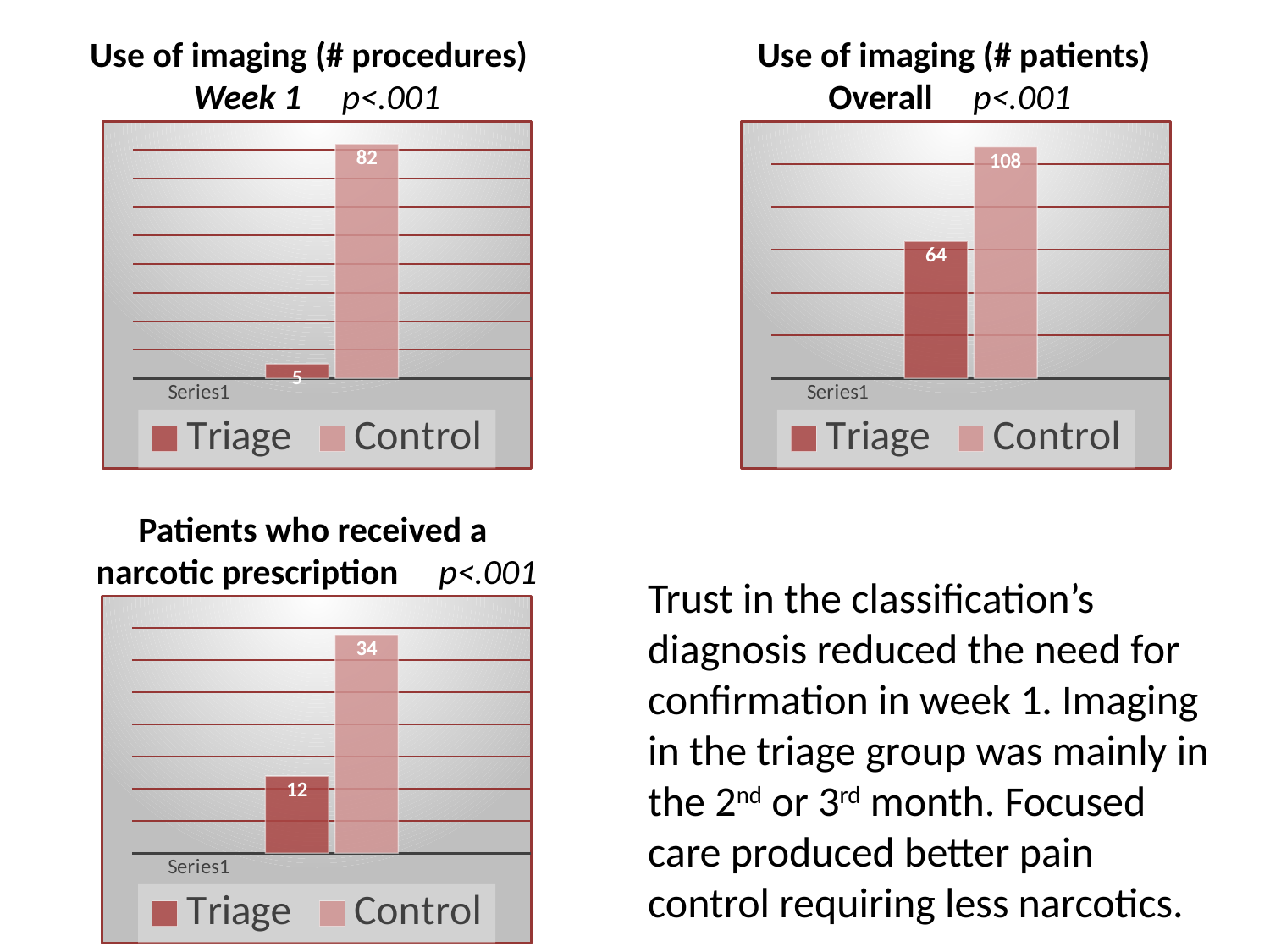
In the 'Use of imaging (# procedures) Week 1' chart, what is the value for Control? 82 In the 'Patients who received a narcotic prescription' chart, which series has the lower value? Triage In the 'Use of imaging (# procedures) Week 1' chart, what is the value for Triage? 5 What type of chart is the 'Use of imaging (# procedures) Week 1' chart? Bar chart In the 'Patients who received a narcotic prescription' chart, what is the value for Control? 34 In the 'Use of imaging (# patients) Overall' chart, what is the value for Control? 108 In the 'Use of imaging (# patients) Overall' chart, what is the difference between the Control and Triage values? 44 In the 'Use of imaging (# patients) Overall' chart, what is the value for Triage? 64 In the 'Use of imaging (# patients) Overall' chart, which series has the higher value? Control In the 'Patients who received a narcotic prescription' chart, what is the value for Triage? 12 How many series does the legend list in the 'Patients who received a narcotic prescription' chart? 2 In the 'Use of imaging (# procedures) Week 1' chart, what is the difference between the Control and Triage values? 77